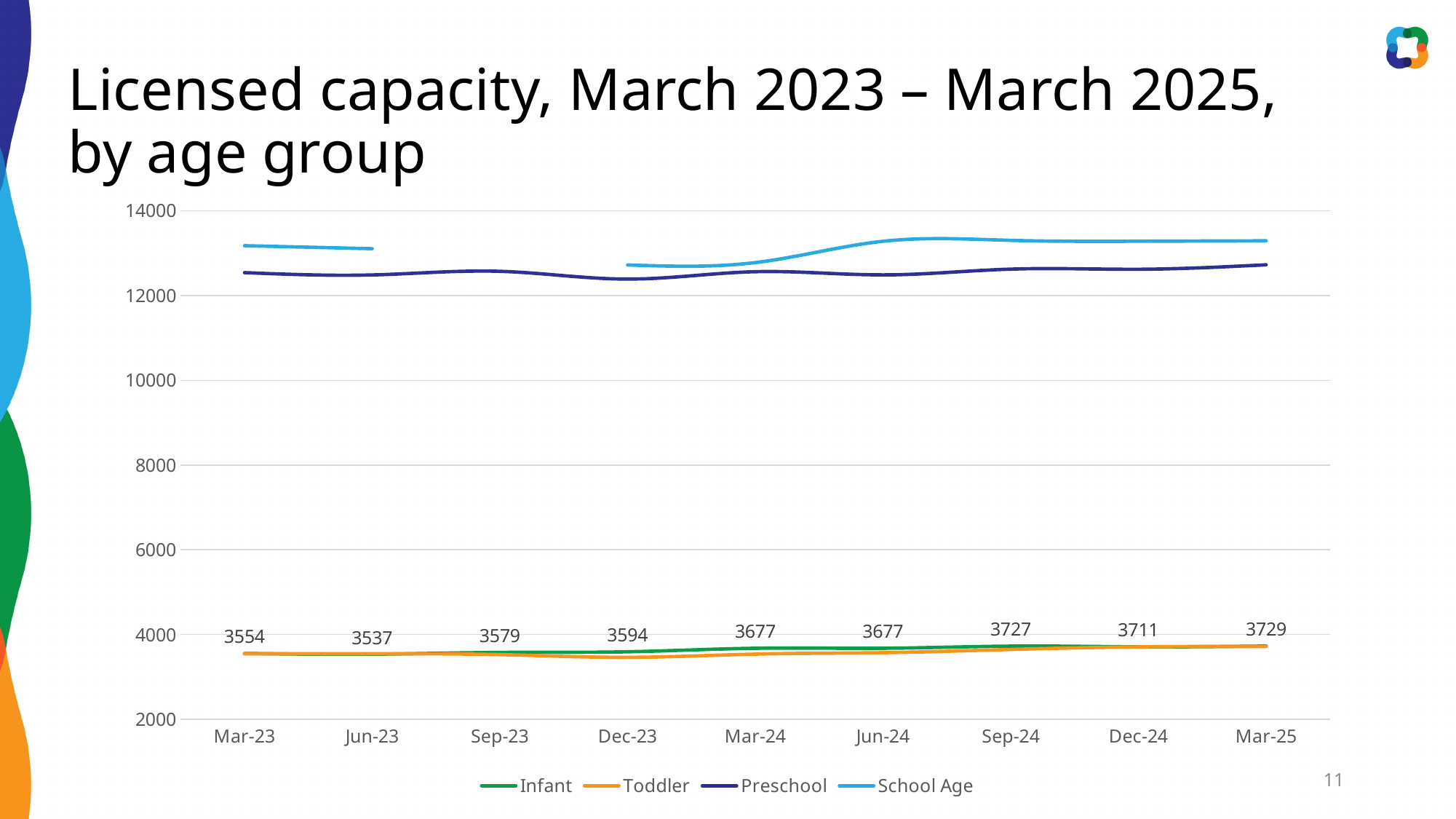
How many series does the legend list? 4 Is the School Age value at Mar-25 greater or less than 12000? greater At Jun-24, which series is higher: School Age or Preschool? School Age Among the labelled values, which time point has the lowest value? Jun-23 What value is labelled on the chart at Sep-24? 3727 Does the School Age line rise or fall between Dec-23 and Jun-24? Rise What value is labelled on the chart at Mar-23? 3554 Is the Preschool value at Dec-23 greater or less than 14000? less What is the difference between the labelled values at Mar-25 and Mar-23? 175 What value is labelled on the chart at Mar-25? 3729 What kind of chart is shown on the slide? Line chart How many time points are shown along the x axis? 9